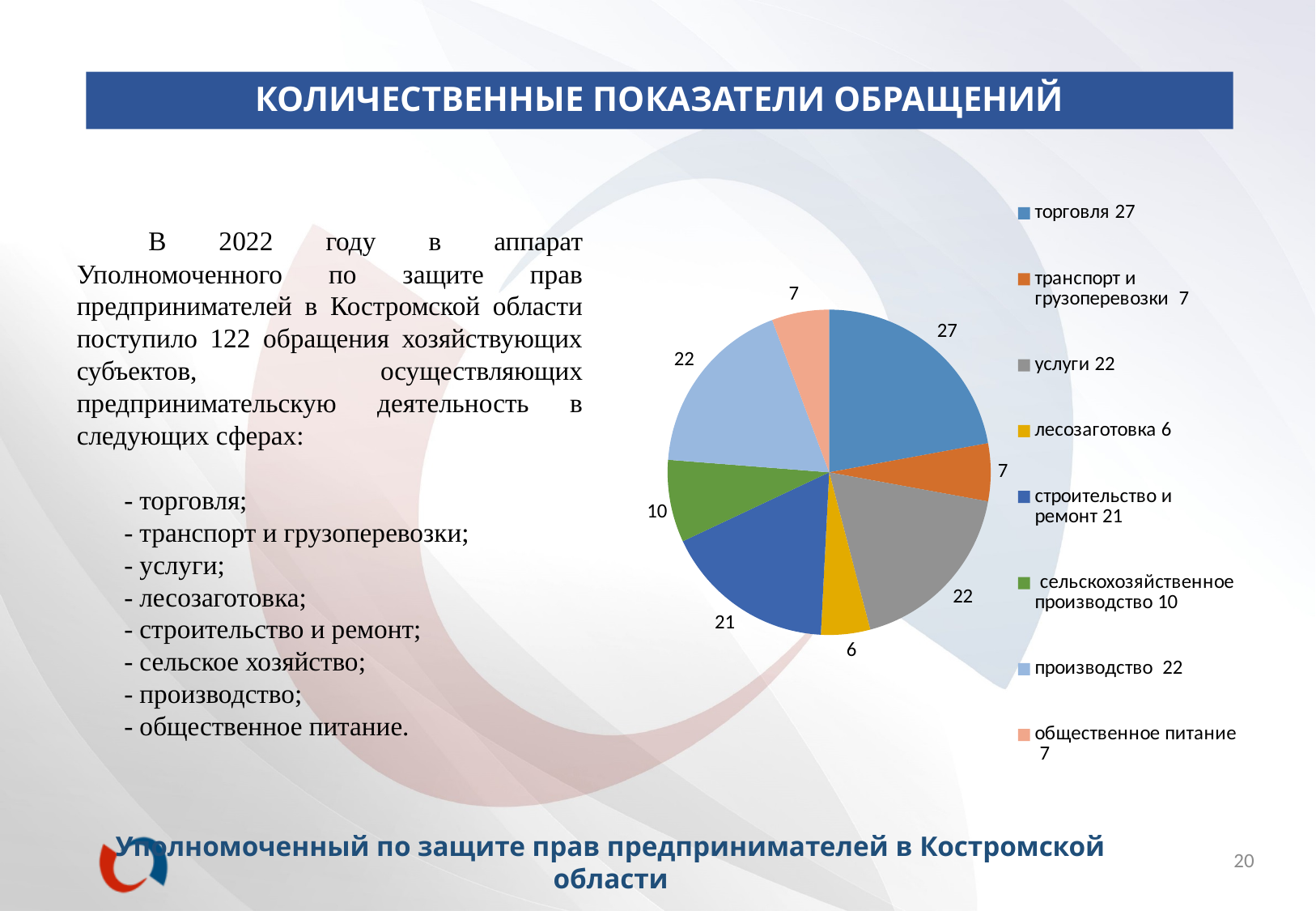
What type of chart is shown on the slide? Pie chart What is the value for общественное питание in the pie chart? 7 What is the total of all slices in the pie chart? 122 Which category has the smallest slice in the pie chart? лесозаготовка What is the difference between the values for торговля and услуги? 5 What is the value for строительство и ремонт in the pie chart? 21 Which is larger: строительство и ремонт or сельскохозяйственное производство? строительство и ремонт How many slices does the pie chart have? 8 What is the title of the slide containing the pie chart? КОЛИЧЕСТВЕННЫЕ ПОКАЗАТЕЛИ ОБРАЩЕНИЙ Which category has the largest slice in the pie chart? торговля What is the value for торговля in the pie chart? 27 What is the value for сельскохозяйственное производство in the pie chart? 10